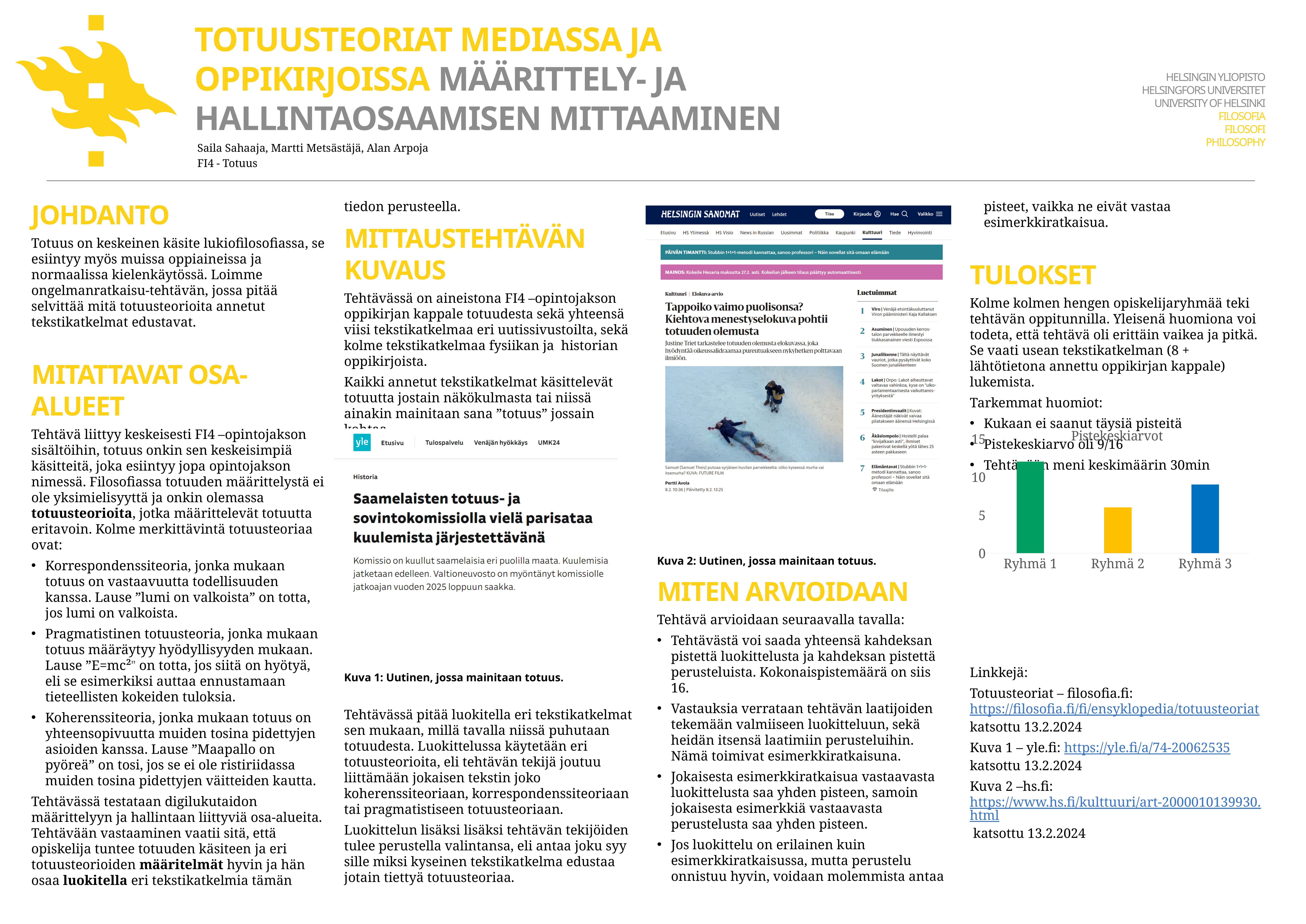
In the Pistekeskiarvot chart, which is larger, the value for Ryhmä 2 or Ryhmä 3? Ryhmä 3 What is the title of the bar chart on the slide? Pistekeskiarvot In the Pistekeskiarvot chart, is the value for Ryhmä 1 greater or less than 10? greater In the Pistekeskiarvot chart, which is larger, the value for Ryhmä 1 or Ryhmä 3? Ryhmä 1 What kind of chart is shown under the Tulokset section? bar chart In the Pistekeskiarvot chart, is the value for Ryhmä 1 greater or less than 15? less In the Pistekeskiarvot chart, is the value for Ryhmä 2 greater or less than 10? less What is the highest tick value shown on the y axis of the Pistekeskiarvot chart? 15 Which group has the lowest bar in the Pistekeskiarvot chart? Ryhmä 2 How many groups (categories) are shown in the Pistekeskiarvot bar chart? 3 Which group has the highest bar in the Pistekeskiarvot chart? Ryhmä 1